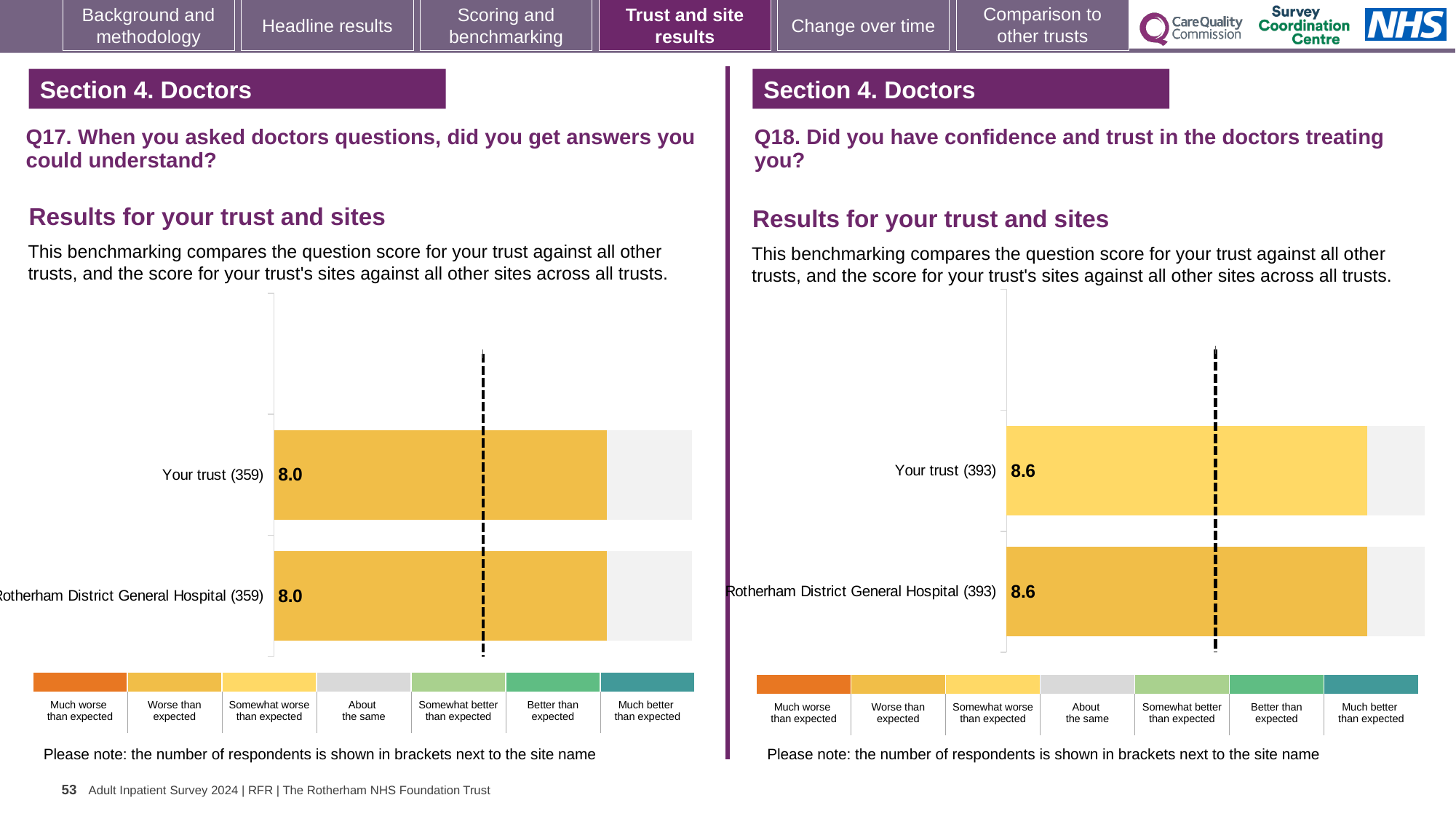
What type of chart is used for the Q18 results on the right? Bar chart In the Q17 chart on the left, what is the difference between the score for Your trust and the score for Rotherham District General Hospital? 0.0 In the Q17 chart on the left, how many respondents are shown in brackets next to Your trust? 359 How many bars are plotted in the Q17 chart on the left? 2 In the Q18 chart on the right, what is the difference between the score for Your trust and the score for Rotherham District General Hospital? 0.0 In the Q18 chart on the right, what is the score for Rotherham District General Hospital (393)? 8.6 How many bars are plotted in the Q18 chart on the right? 2 In the Q18 chart on the right, what is the score for Your trust (393)? 8.6 In the Q18 chart on the right, how many respondents are shown in brackets next to Rotherham District General Hospital? 393 In the Q17 chart on the left, what is the score for Your trust (359)? 8.0 In the Q17 chart on the left, what is the score for Rotherham District General Hospital (359)? 8.0